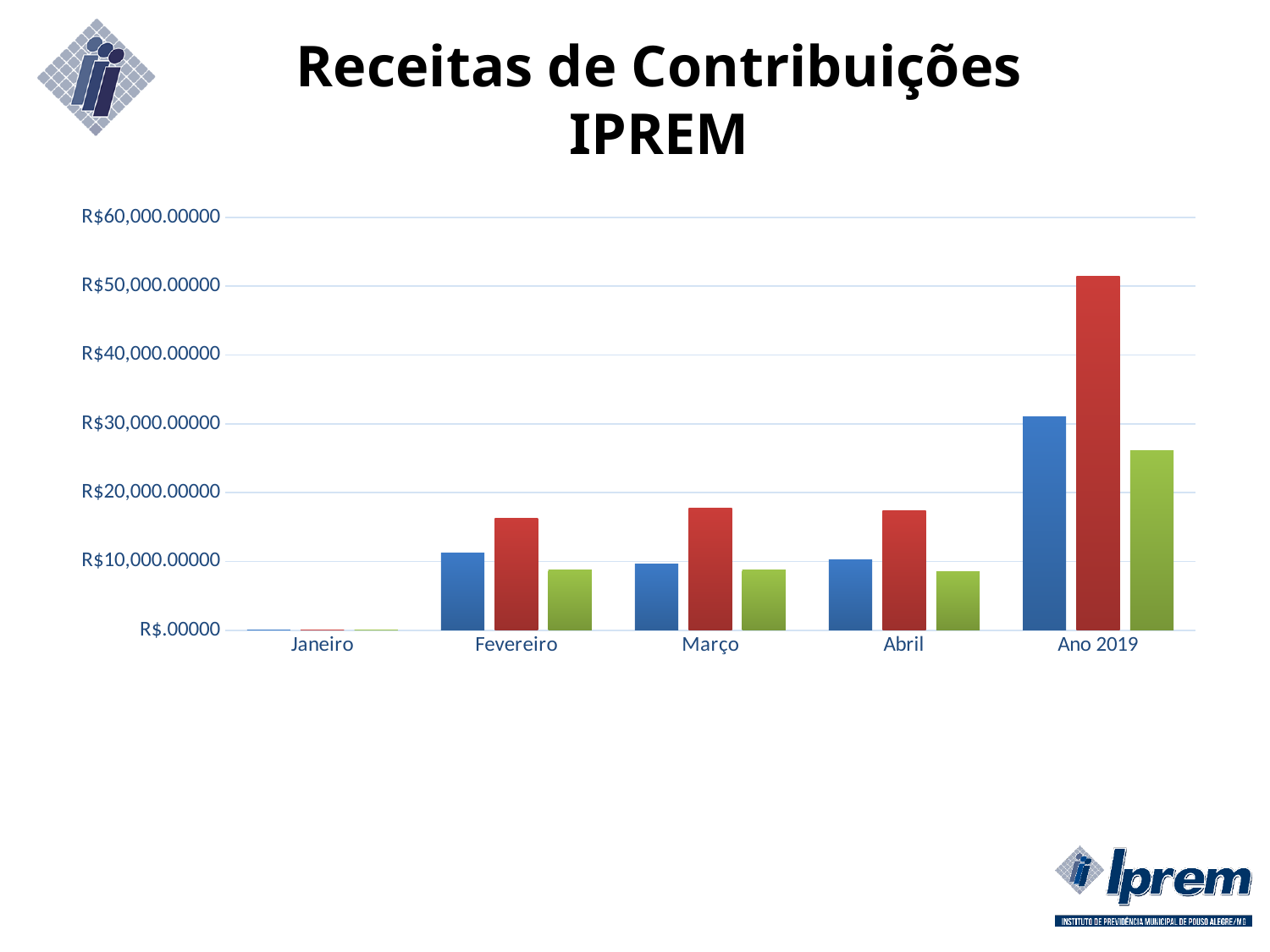
In Fevereiro, which bar is taller, the blue bar or the red bar? the red bar Is the value of the green bar for Ano 2019 greater or less than R$30,000.00000? less Is the value of the red bar for Março greater or less than R$20,000.00000? less Which category has the tallest bars in the chart? Ano 2019 Which category has the lowest values in the chart? Janeiro How many categories are shown on the x axis of the chart? 5 Is the value of the red bar for Ano 2019 greater or less than R$40,000.00000? greater What is the title of the chart on the slide? Receitas de Contribuições IPREM In Abril, which bar is taller, the red bar or the green bar? the red bar What kind of chart is shown on the slide? bar chart